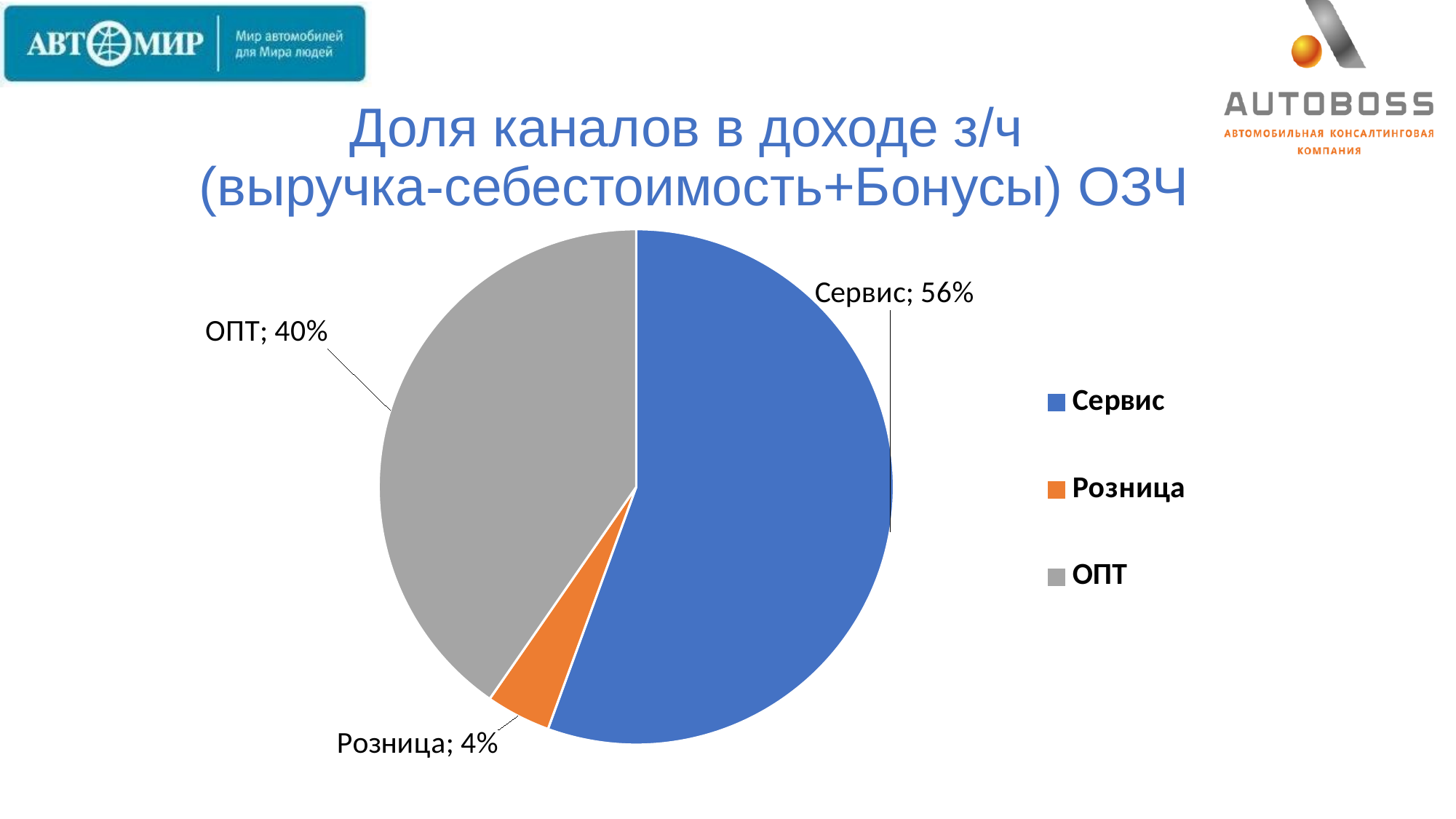
What is the difference in percentage points between the shares of Сервис and ОПТ? 16 What colour is the slice for ОПТ? Grey What kind of chart is shown on the slide? Pie chart What share of the pie does Розница have? 4% Which channel has the smallest share of the pie? Розница What share of the pie does ОПТ have? 40% What share of the pie does Сервис have? 56% How many entries does the legend list? 3 Which channel has the largest share of the pie? Сервис Which has a larger share, ОПТ or Розница? ОПТ What is the title of the slide? Доля каналов в доходе з/ч (выручка-себестоимость+Бонусы) ОЗЧ How many slices does the pie chart have? 3